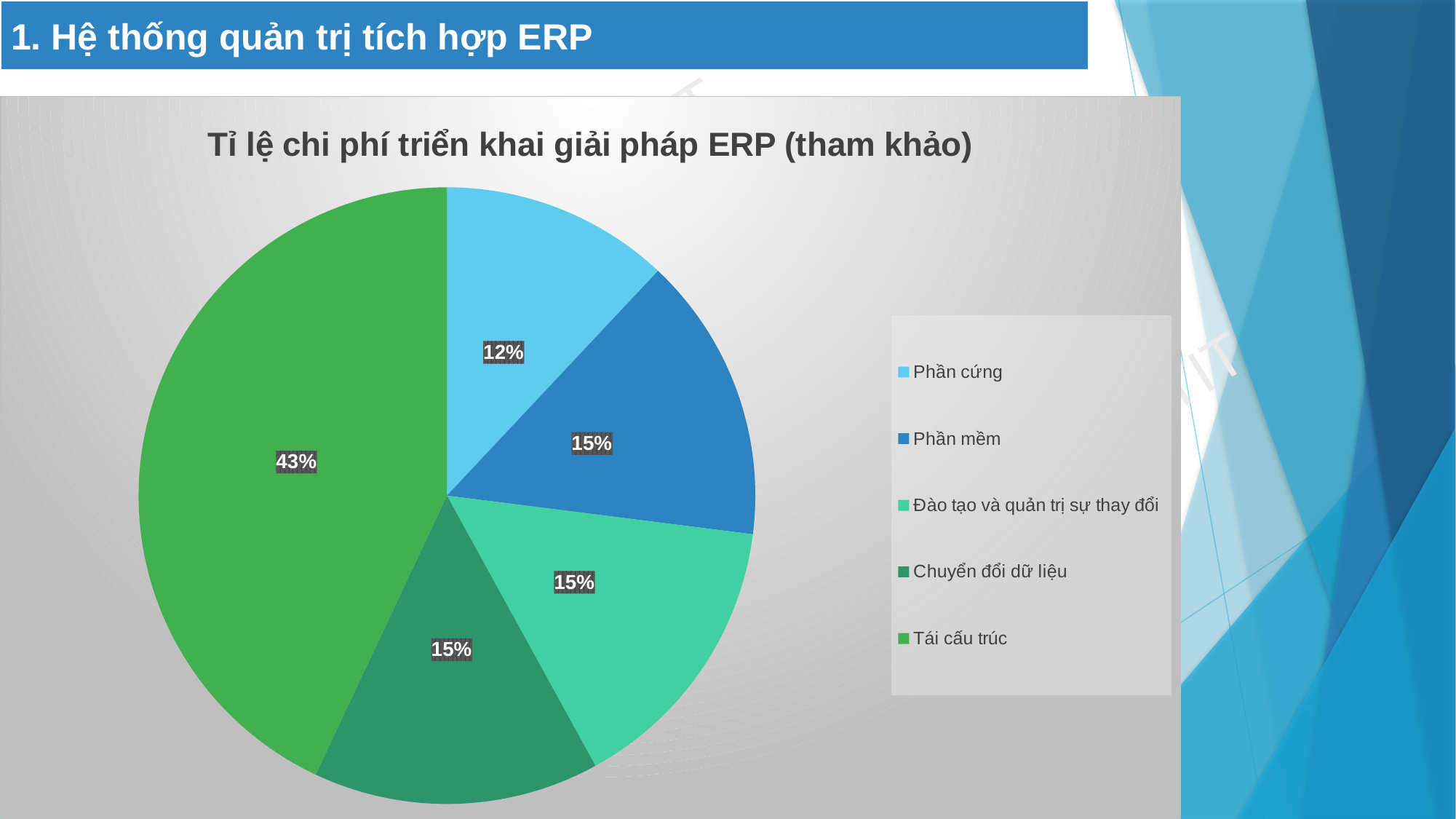
Which category has the smallest slice? Phần cứng What is the value for Chuyển đổi dữ liệu? 15% Which category has the largest slice? Tái cấu trúc Which is larger, the value for Phần mềm or the value for Phần cứng? Phần mềm What is the title of the chart? Tỉ lệ chi phí triển khai giải pháp ERP (tham khảo) What is the value for Phần cứng? 12% What kind of chart is shown on the slide? pie chart What share of the pie does Tái cấu trúc take? 43% What is the difference between the values for Tái cấu trúc and Phần cứng? 31% How many entries does the legend list? 5 How many categories does the pie chart have? 5 What is the value for Phần mềm? 15%